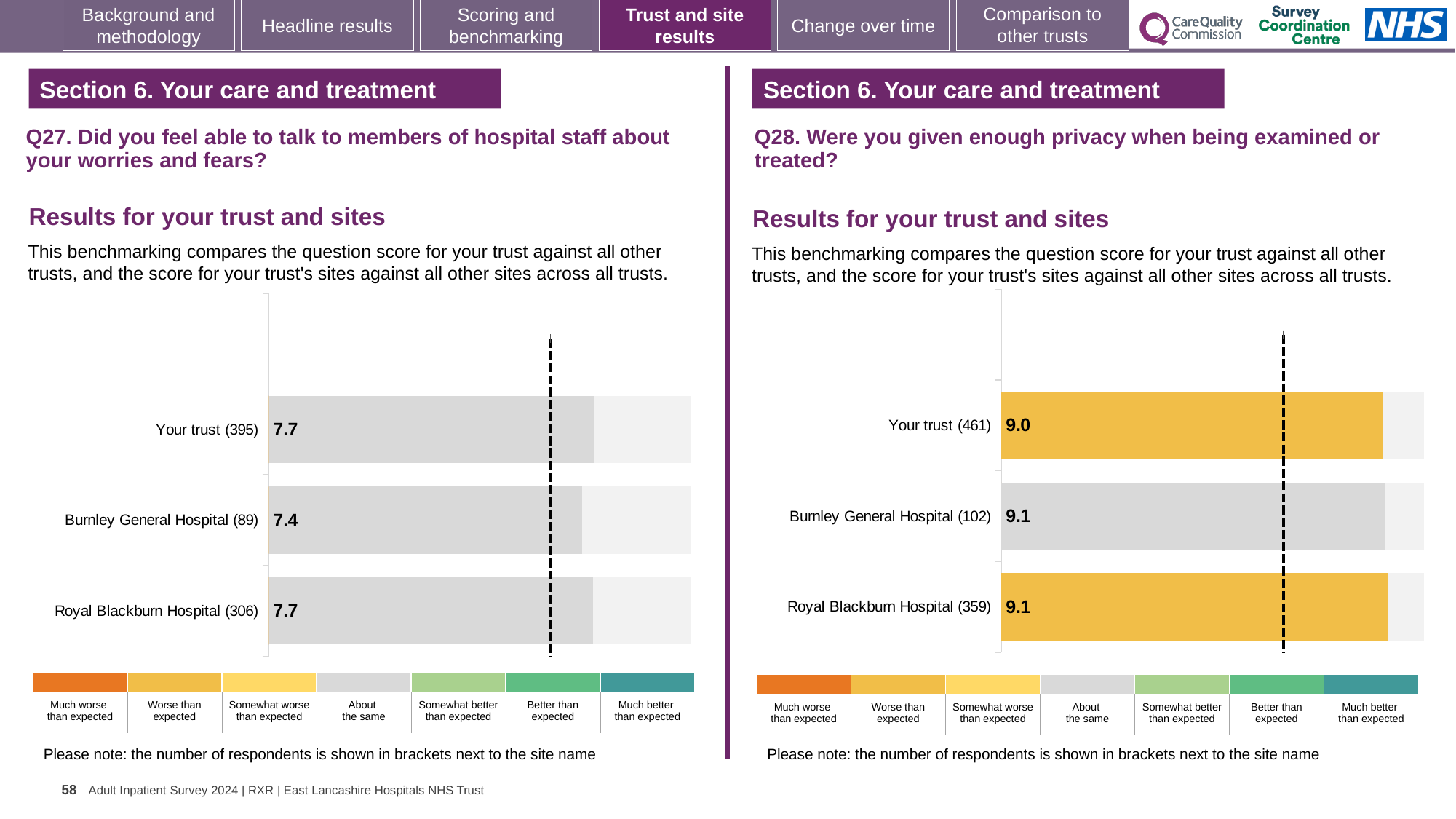
In the Q27 chart on the left, which site has the lowest score? Burnley General Hospital (89) In the Q27 chart on the left, how many bars are plotted? 3 In the Q27 chart on the left, what is the score for Burnley General Hospital (89)? 7.4 In the Q27 chart on the left, what is the difference between the scores for Royal Blackburn Hospital (306) and Burnley General Hospital (89)? 0.3 In the Q28 chart on the right, what is the score for Royal Blackburn Hospital (359)? 9.1 In the Q27 chart on the left, what is the score for Your trust (395)? 7.7 In the Q27 chart on the left, how many respondents are shown for Royal Blackburn Hospital? 306 In the Q28 chart on the right, what is the difference between the scores for Burnley General Hospital (102) and Your trust (461)? 0.1 In the Q28 chart on the right, which benchmark category does the colour of the Your trust (461) bar correspond to in the legend? Worse than expected What kind of chart is the Q28 chart on the right? Bar chart In the Q28 chart on the right, what is the score for Your trust (461)? 9.0 In the Q28 chart on the right, which is larger: the score for Burnley General Hospital (102) or Your trust (461)? Burnley General Hospital (102)